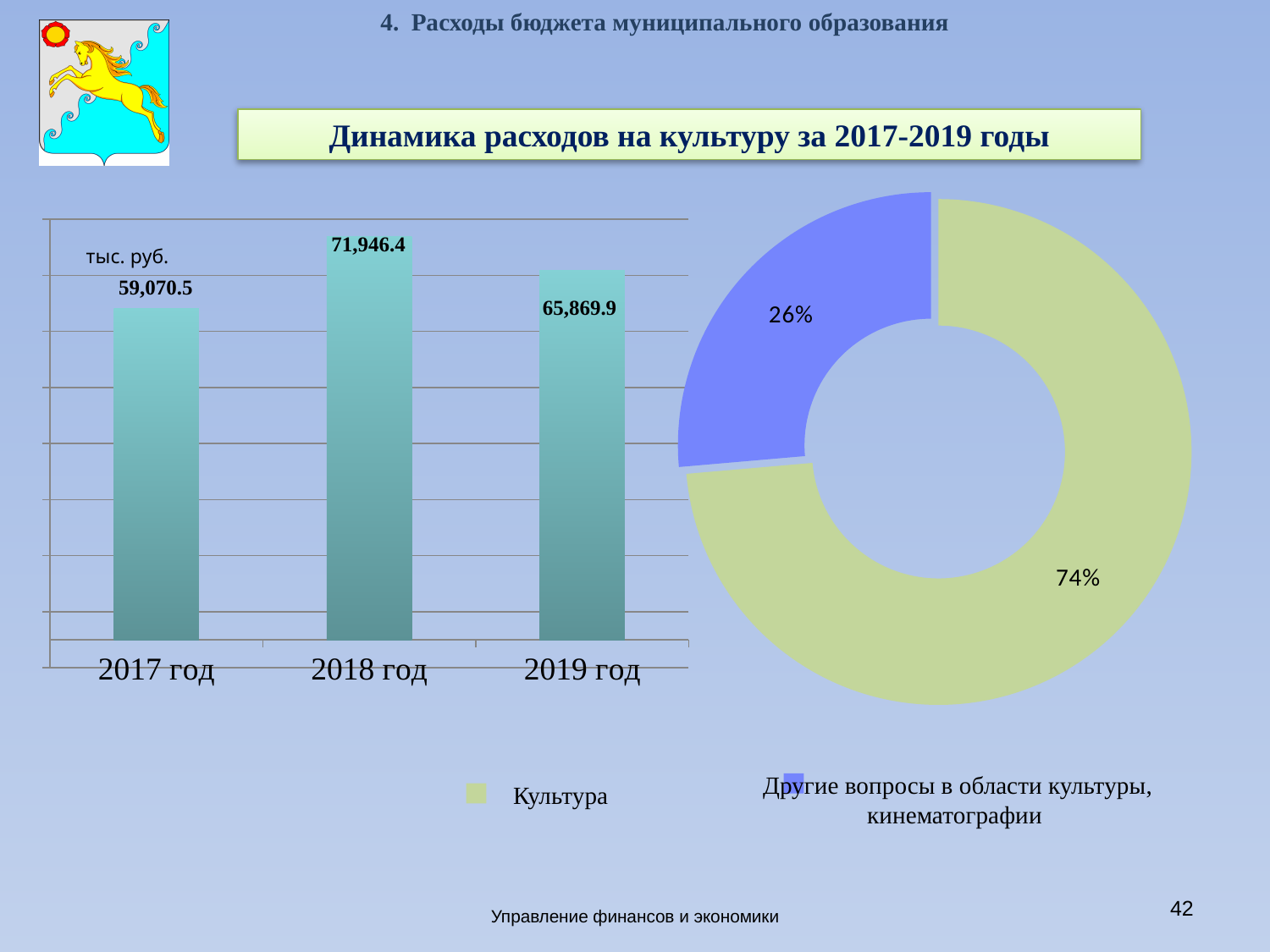
What kind of chart is the chart on the left of the slide? bar chart On the doughnut chart on the right, what share does Другие вопросы в области культуры, кинематографии have? 26% On the doughnut chart on the right, what share does Культура have? 74% On the bar chart on the left, how many years are shown? 3 On the bar chart on the left, what is the value for 2019 год? 65,869.9 On the bar chart on the left, which is larger: the value for 2019 год or the value for 2017 год? 2019 год On the bar chart on the left, what is the value for 2018 год? 71,946.4 On the bar chart on the left, what is the difference between the values for 2018 год and 2017 год? 12,875.9 On the bar chart on the left, which year has the lowest value? 2017 год On the bar chart on the left, what is the difference between the values for 2018 год and 2019 год? 6,076.5 On the bar chart on the left, what is the value for 2017 год? 59,070.5 On the bar chart on the left, which year has the highest value? 2018 год